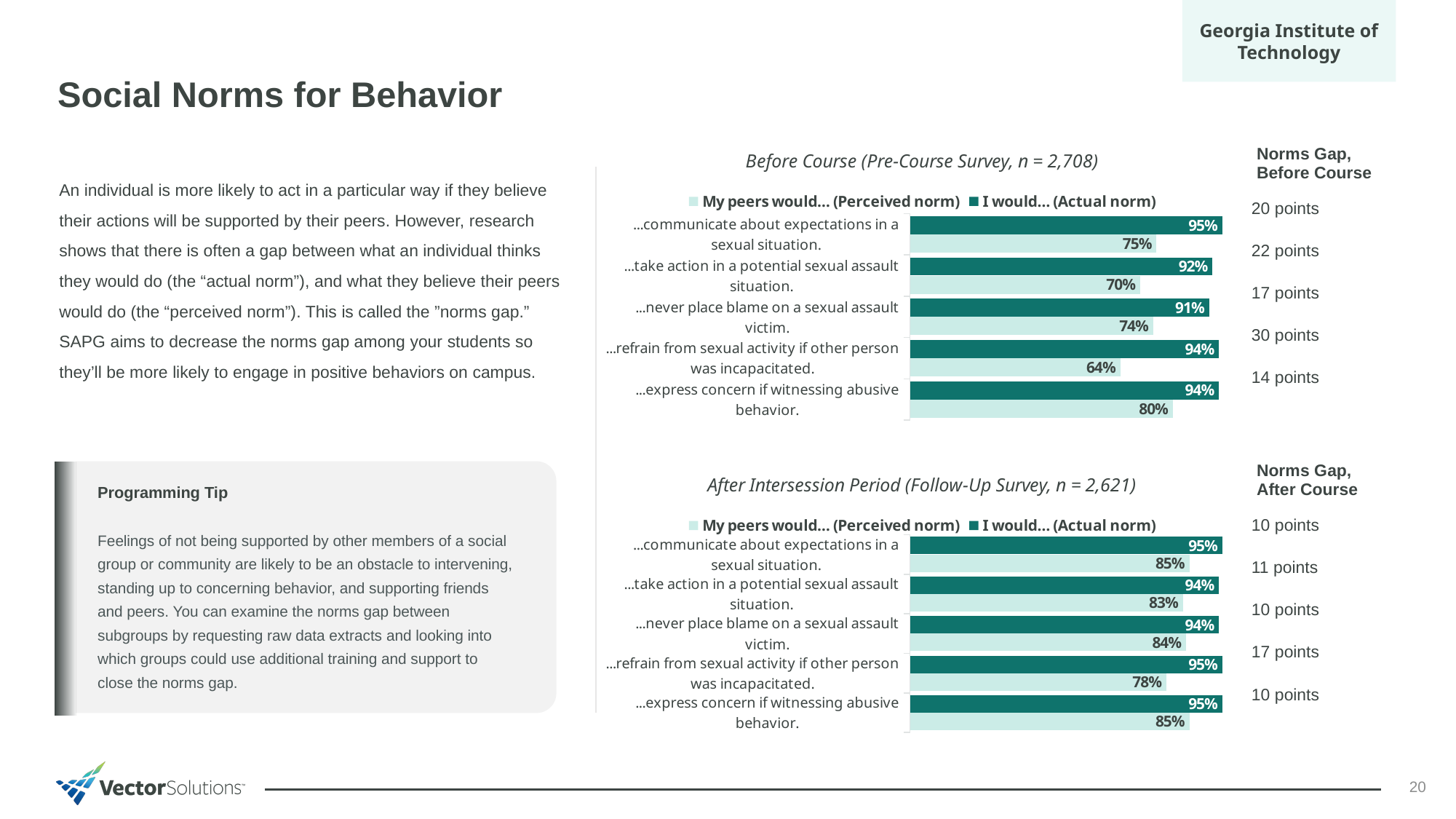
In the Before Course chart, which behavior has the lowest perceived norm (My peers would...) value? ...refrain from sexual activity if other person was incapacitated. In the After Intersession Period chart, which behavior has the lowest perceived norm (My peers would...) value? ...refrain from sexual activity if other person was incapacitated. In the After Intersession Period chart, what is the perceived norm (My peers would...) value for taking action in a potential sexual assault situation? 83% In the Before Course chart, which behavior has the highest perceived norm (My peers would...) value? ...express concern if witnessing abusive behavior. What type of chart is used for the Before Course (Pre-Course Survey) data? Bar chart How many behaviors (categories) are shown in the After Intersession Period chart? 5 In the Before Course chart, what percentage said they would communicate about expectations in a sexual situation (I would... Actual norm)? 95% In the Before Course chart, what is the difference between the actual norm and the perceived norm for never placing blame on a sexual assault victim? 17 percentage points In the Before Course chart, what is the perceived norm (My peers would...) value for refraining from sexual activity if the other person was incapacitated? 64% How many series does the legend of the Before Course chart list? 2 In the Before Course chart, which is larger: the perceived norm for expressing concern if witnessing abusive behavior or the perceived norm for taking action in a potential sexual assault situation? Expressing concern if witnessing abusive behavior (80%) In the After Intersession Period chart, what is the difference between the actual norm and the perceived norm for refraining from sexual activity if the other person was incapacitated? 17 percentage points